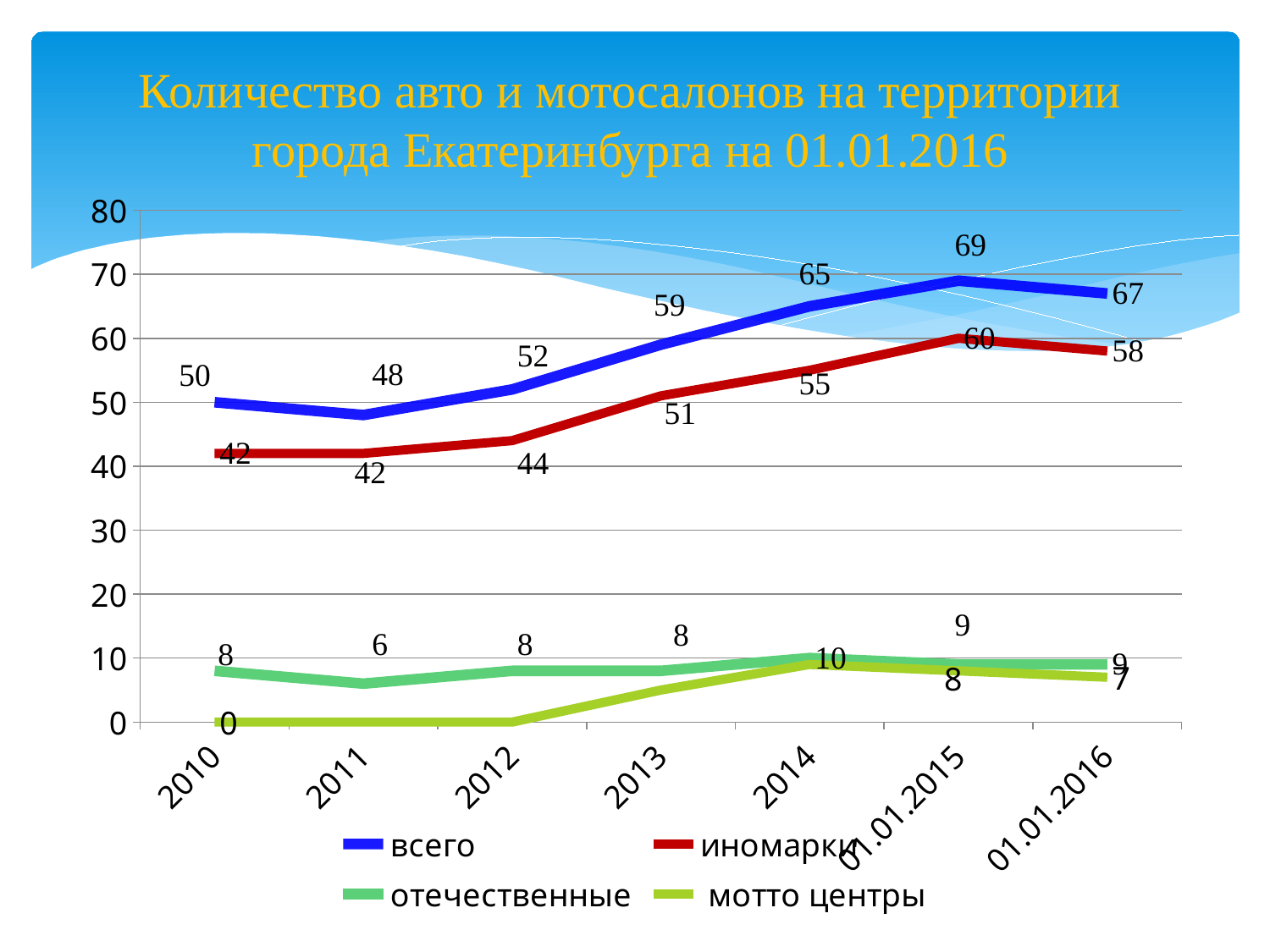
What is the difference between the всего value on 01.01.2016 and in 2010? 17 What is the value of the всего series in 2013? 59 In which year or date does the всего series reach its highest value? 01.01.2015 What is the value of the иномарки series on 01.01.2015? 60 What is the value of the отечественные series in 2011? 6 How many points are plotted along the x axis for each series? 7 What kind of chart is shown on the slide? line chart In which year does the всего series have its lowest value? 2011 Which is larger for the иномарки series: the value in 2013 or in 2014? 2014 How many series does the legend list? 4 Does the всего series rise or fall from 2012 to 01.01.2015? rise What colour is the line for the всего series? blue